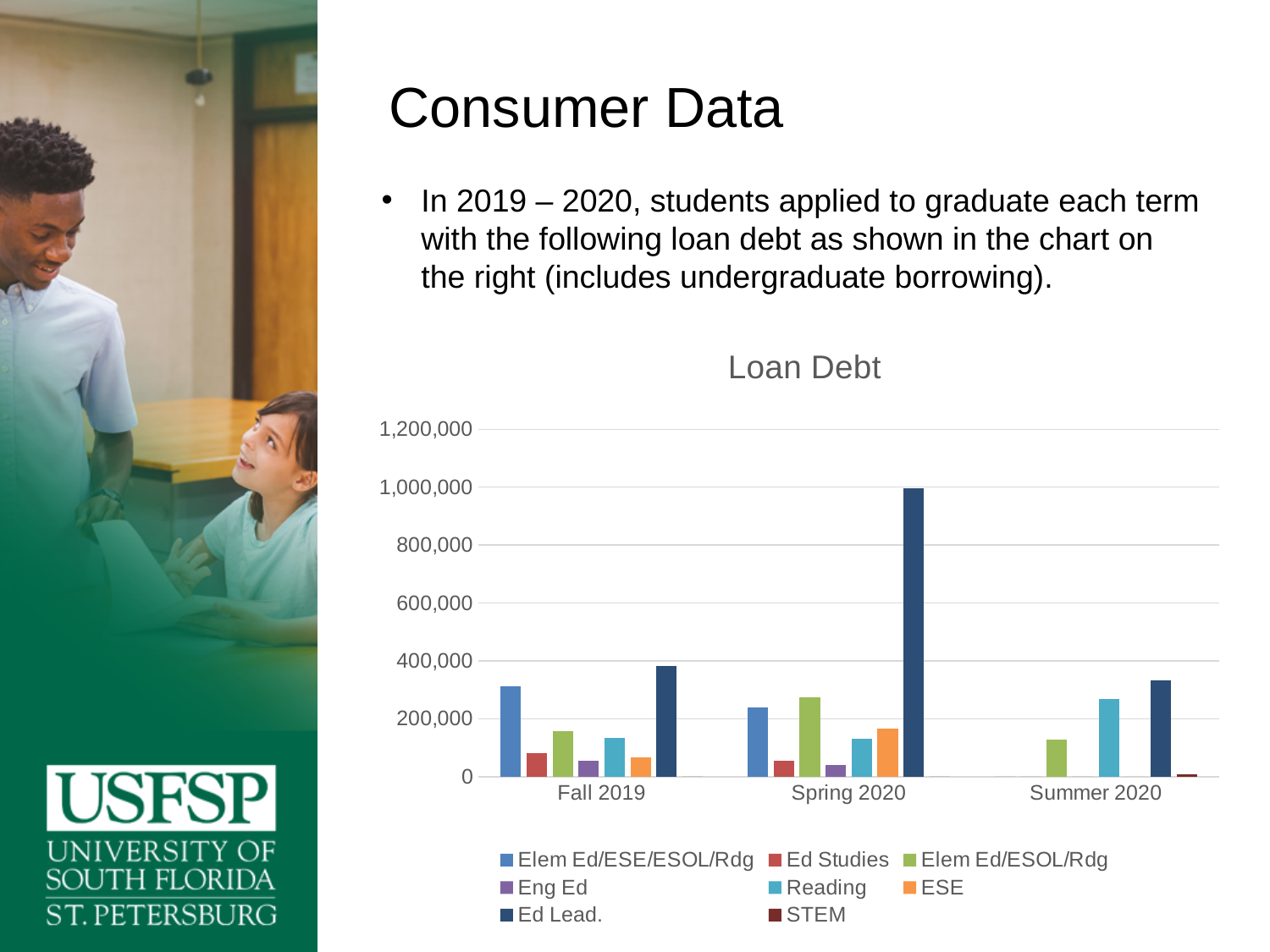
Is the Ed Lead. value for Spring 2020 greater or less than 800,000? greater Is the Reading value for Summer 2020 greater or less than 200,000? greater What kind of chart is shown on the slide? bar chart Which term has the tallest bar in the chart? Spring 2020 How many series does the chart's legend list? 8 Which is larger in Spring 2020: the ESE bar or the Eng Ed bar? ESE What is the title of the chart? Loan Debt Which is larger in Fall 2019: the Elem Ed/ESE/ESOL/Rdg bar or the Ed Studies bar? Elem Ed/ESE/ESOL/Rdg How many terms (categories) are shown on the x axis of the chart? 3 Which series has the highest loan debt in Spring 2020? Ed Lead. Is the Ed Lead. value for Fall 2019 greater or less than 400,000? less